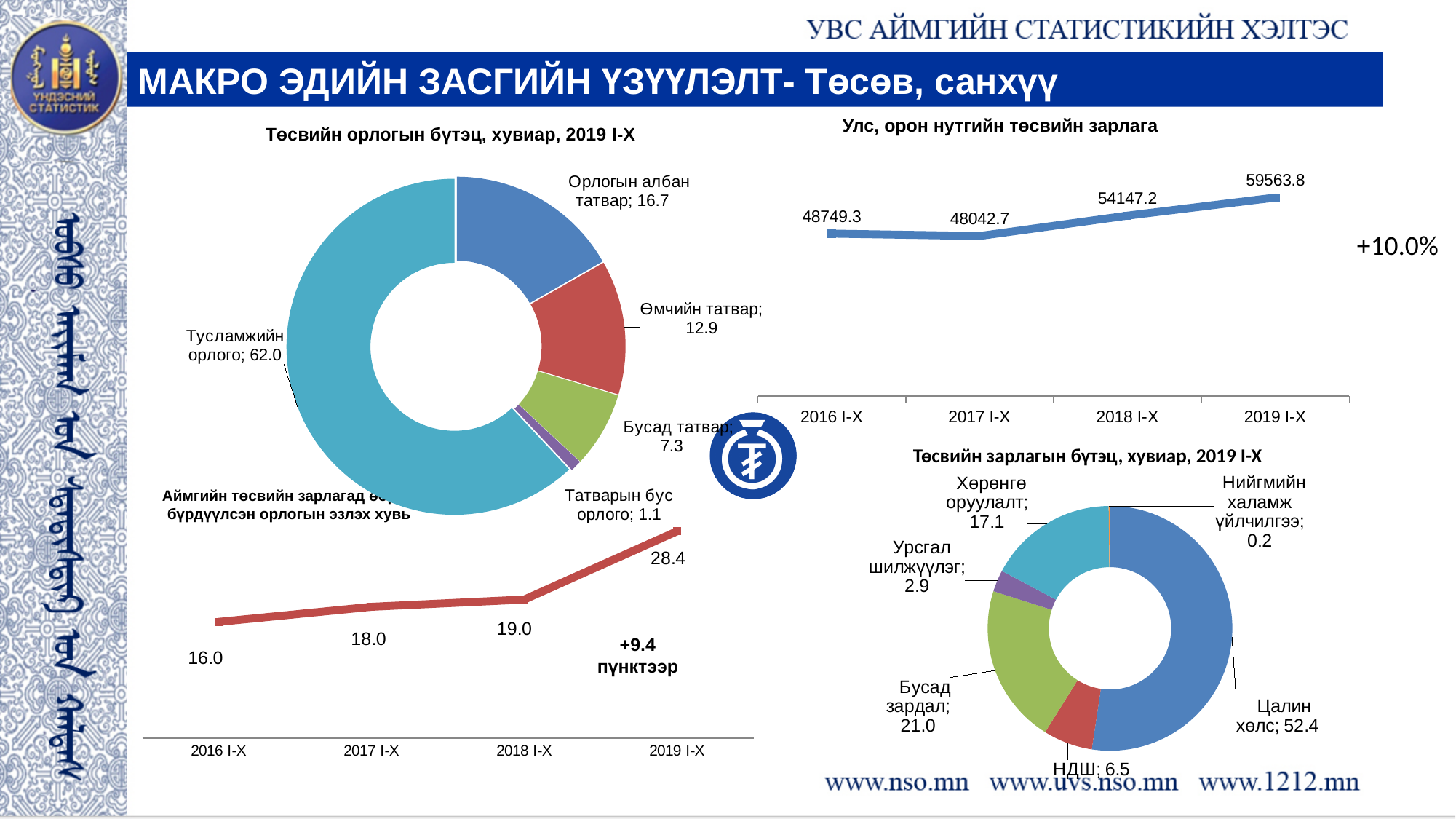
In the chart titled "Төсвийн зарлагын бүтэц, хувиар, 2019 I-X", which category has the largest share? Цалин хөлс In the bottom-left line chart, what is the value for 2019 I-X? 28.4 In the chart titled "Улс, орон нутгийн төсвийн зарлага", which period has the lowest value? 2017 I-X In the chart titled "Төсвийн орлогын бүтэц, хувиар, 2019 I-X", what is the value for Тусламжийн орлого? 62.0 In the chart titled "Улс, орон нутгийн төсвийн зарлага", how many periods are plotted? 4 What kind of chart is the top-left chart titled "Төсвийн орлогын бүтэц, хувиар, 2019 I-X"? Doughnut chart In the chart titled "Төсвийн орлогын бүтэц, хувиар, 2019 I-X", which category has the smallest share? Татварын бус орлого In the chart titled "Улс, орон нутгийн төсвийн зарлага", what is the difference between 2019 I-X and 2018 I-X? 5416.6 In the chart titled "Төсвийн орлогын бүтэц, хувиар, 2019 I-X", what is the difference between Орлогын албан татвар and Өмчийн татвар? 3.8 In the bottom-left line chart, do the values rise or fall from 2016 I-X to 2019 I-X? Rise In the chart titled "Төсвийн зарлагын бүтэц, хувиар, 2019 I-X", which is larger: Бусад зардал or Хөрөнгө оруулалт? Бусад зардал In the chart titled "Улс, орон нутгийн төсвийн зарлага", what is the value for 2019 I-X? 59563.8